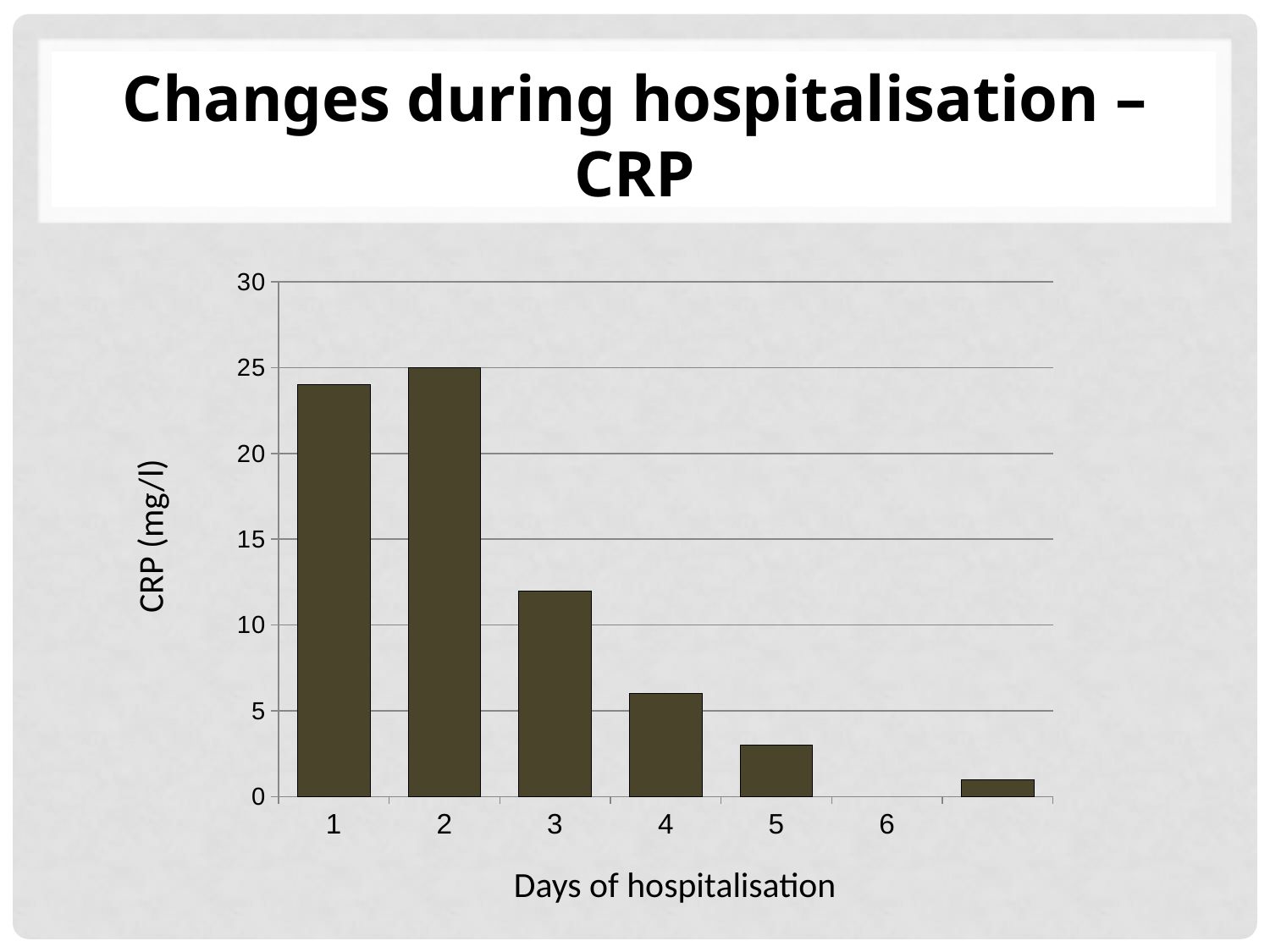
What is the label of the y axis? CRP (mg/l) Is the CRP value on day 3 greater or less than 15? less From day 2 onwards, do the CRP values rise or fall along the x axis? fall Which is larger, the CRP value on day 4 or on day 5? day 4 Is the CRP value on day 1 greater or less than 20? greater What is the CRP value on day 2 of hospitalisation? 25 Is the CRP value on day 5 greater or less than 5? less What kind of chart is shown on the slide? bar chart What is the label of the x axis? Days of hospitalisation Which is larger, the CRP value on day 2 or on day 3? day 2